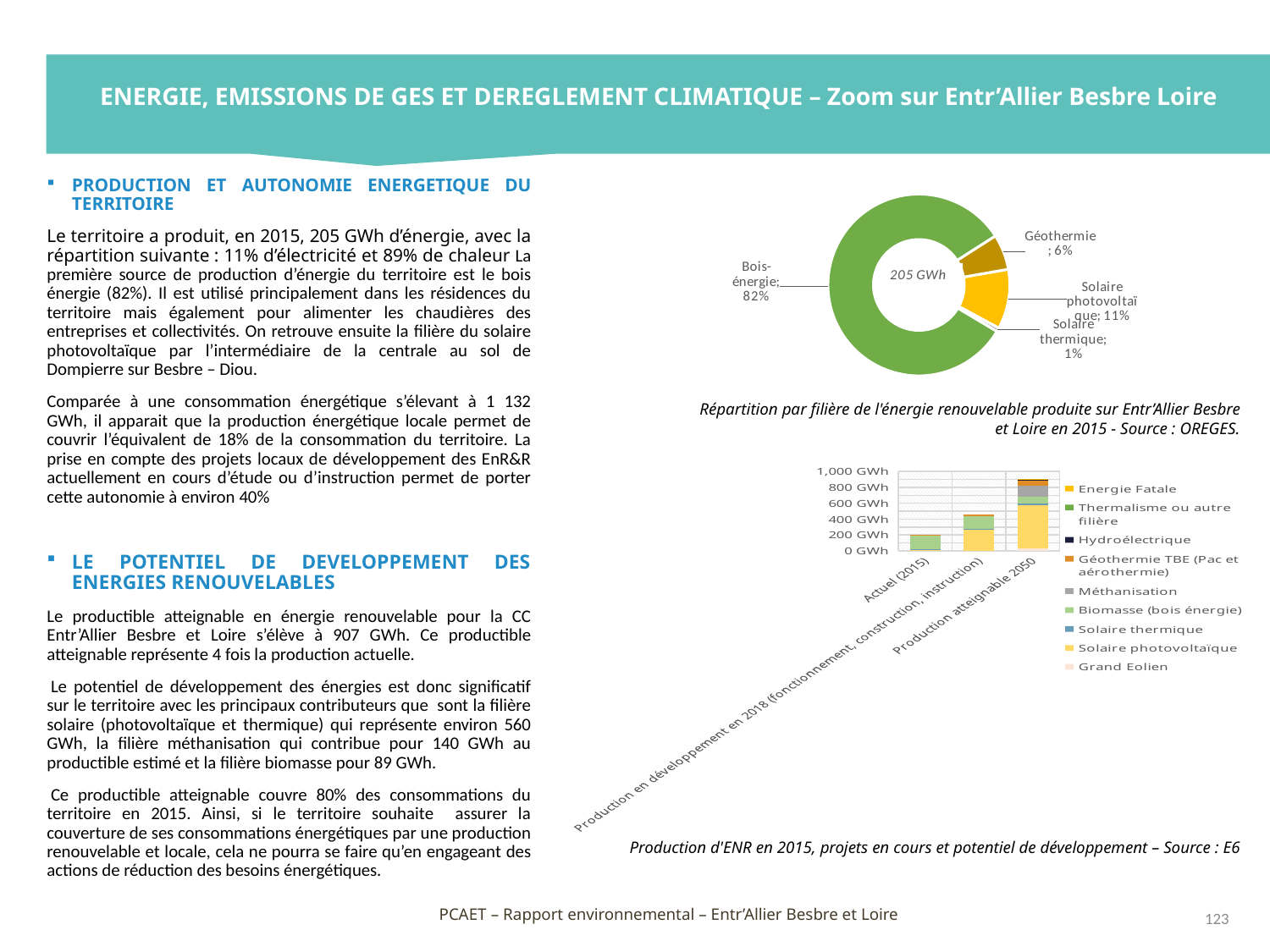
In the donut chart 'Répartition par filière de l'énergie renouvelable produite', which filière has the smallest share? Solaire thermique What kind of chart is 'Production d'ENR en 2015, projets en cours et potentiel de développement'? Stacked bar chart In the donut chart 'Répartition par filière de l'énergie renouvelable produite', which filière has the largest share? Bois-énergie In the chart 'Production d'ENR en 2015, projets en cours et potentiel de développement', is the total for 'Production atteignable 2050' greater or less than 800 GWh? greater In the chart 'Production d'ENR en 2015, projets en cours et potentiel de développement', how many series does the legend list? 9 In the donut chart 'Répartition par filière de l'énergie renouvelable produite', how many filières are shown? 4 In the donut chart 'Répartition par filière de l'énergie renouvelable produite', what share does Solaire photovoltaïque represent? 11% In the donut chart 'Répartition par filière de l'énergie renouvelable produite', what share does Bois-énergie represent? 82% In the donut chart 'Répartition par filière de l'énergie renouvelable produite', what is the difference in share between Solaire photovoltaïque and Géothermie? 5% In the chart 'Production d'ENR en 2015, projets en cours et potentiel de développement', do the bar totals rise or fall from 'Actuel (2015)' to 'Production atteignable 2050'? rise In the donut chart 'Répartition par filière de l'énergie renouvelable produite', what total value is shown in the centre of the chart? 205 GWh In the donut chart 'Répartition par filière de l'énergie renouvelable produite', what share does Géothermie represent? 6%